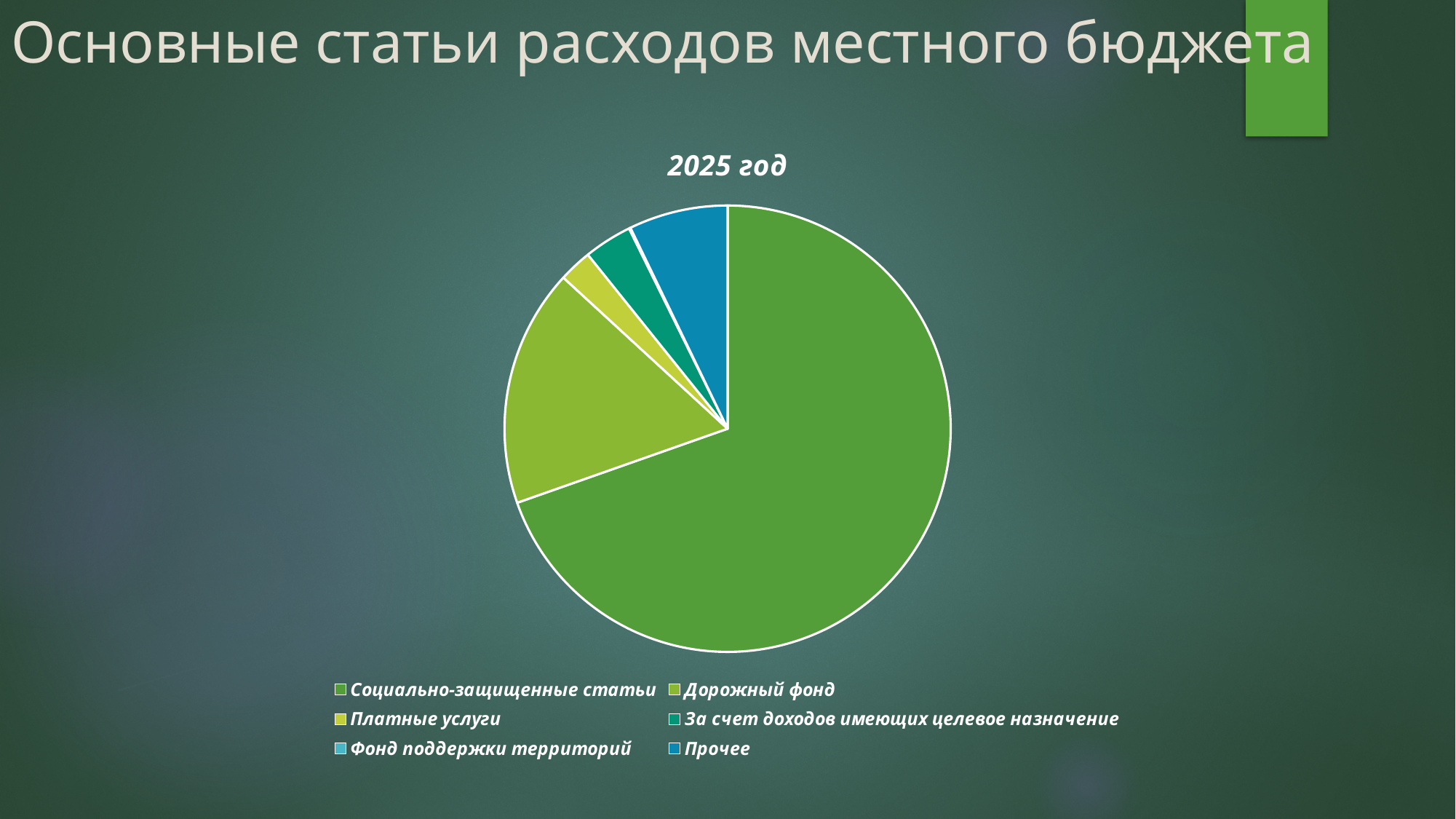
Which is larger, the slice for Социально-защищенные статьи or the slice for Дорожный фонд? Социально-защищенные статьи Which category has the largest slice of the pie? Социально-защищенные статьи Which category has the second-largest slice of the pie? Дорожный фонд What is the title of the chart? 2025 год What kind of chart is shown on the slide? pie chart Which is larger, the slice for Прочее or the slice for Платные услуги? Прочее Which is larger, the slice for Дорожный фонд or the slice for Прочее? Дорожный фонд How many entries does the chart legend list? 6 Does the slice for Социально-защищенные статьи take up more or less than half of the pie? more